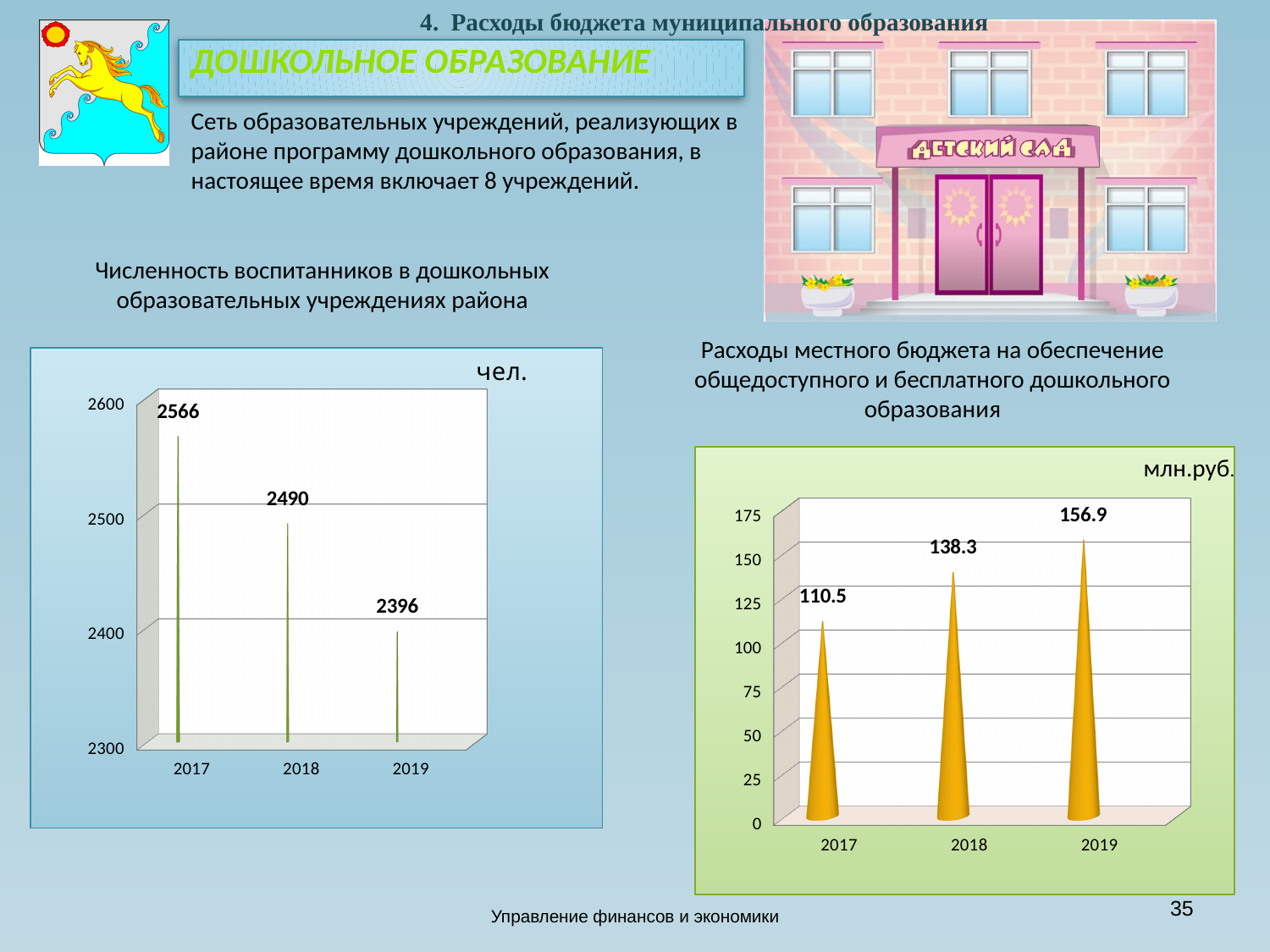
In the chart 'Численность воспитанников в дошкольных образовательных учреждениях района', what unit is shown in the top right corner of the plot? чел. In the chart 'Численность воспитанников в дошкольных образовательных учреждениях района', what is the value for 2019? 2396 In the chart 'Расходы местного бюджета на обеспечение общедоступного и бесплатного дошкольного образования', what is the value for 2018? 138.3 In the chart 'Численность воспитанников в дошкольных образовательных учреждениях района', do the values rise or fall from 2017 to 2019? fall In the chart 'Расходы местного бюджета на обеспечение общедоступного и бесплатного дошкольного образования', is the value for 2017 greater or less than 125? less In the chart 'Расходы местного бюджета на обеспечение общедоступного и бесплатного дошкольного образования', which year has the highest value? 2019 What kind of chart is the one titled 'Расходы местного бюджета на обеспечение общедоступного и бесплатного дошкольного образования'? bar chart In the chart 'Численность воспитанников в дошкольных образовательных учреждениях района', what is the difference between the 2017 and 2019 values? 170 In the chart 'Расходы местного бюджета на обеспечение общедоступного и бесплатного дошкольного образования', how many years are plotted? 3 In the chart 'Расходы местного бюджета на обеспечение общедоступного и бесплатного дошкольного образования', what is the difference between the 2019 and 2017 values? 46.4 In the chart 'Численность воспитанников в дошкольных образовательных учреждениях района', which year has the lowest value? 2019 In the chart 'Численность воспитанников в дошкольных образовательных учреждениях района', what is the value for 2017? 2566